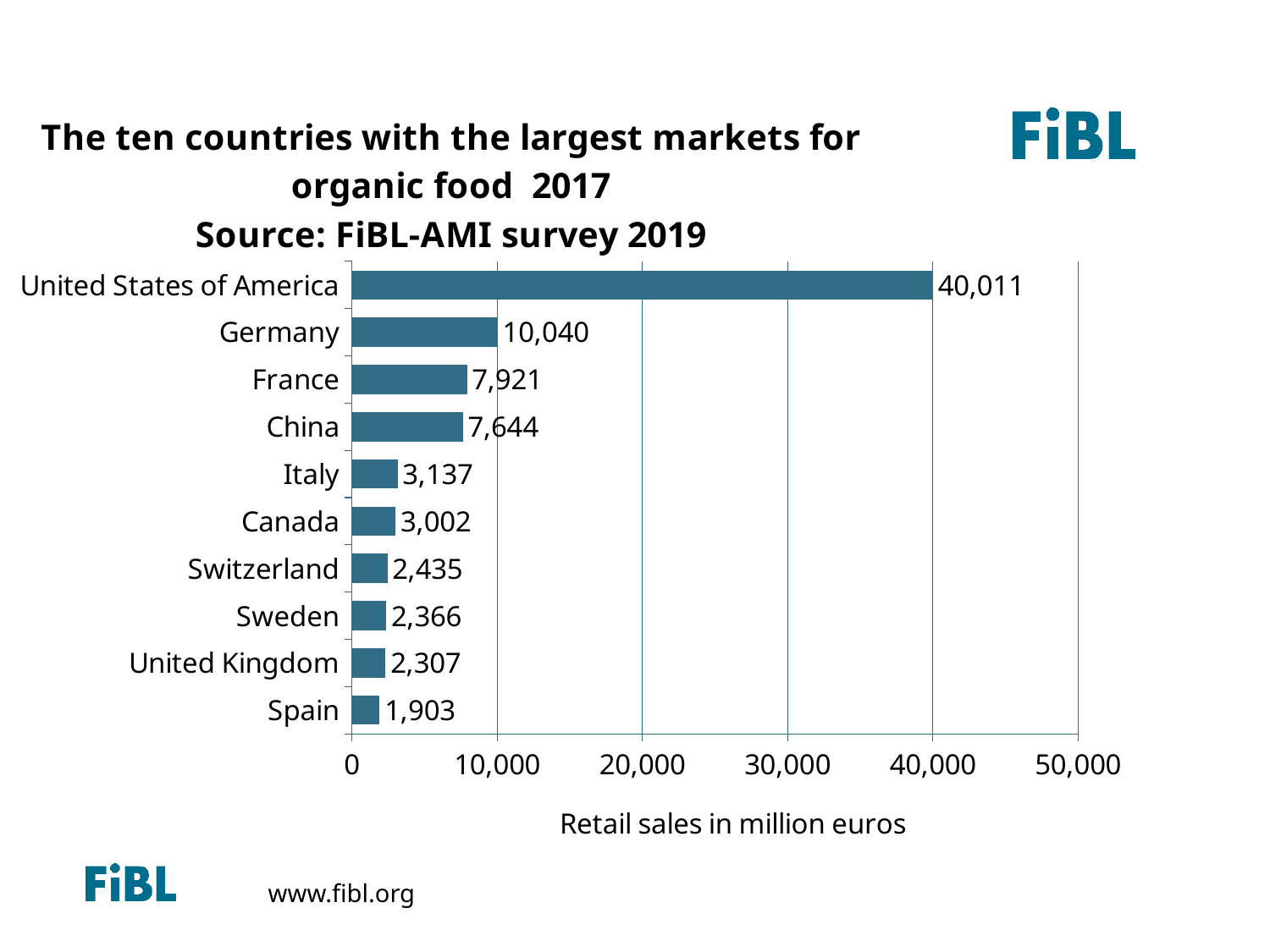
What is the retail sales value for Switzerland? 2,435 Is the value for Germany greater or less than 10,000? greater What is the label of the horizontal axis? Retail sales in million euros What is the retail sales value for Germany? 10,040 Which country has the largest market for organic food? United States of America What kind of chart is shown on the slide? bar chart Which country has the smallest value shown on the chart? Spain What is the retail sales value for China? 7,644 What is the difference between the values for France and China? 277 What is the difference between the values for the United States of America and Germany? 29,971 Which has a higher value, Italy or Canada? Italy How many countries are shown on the chart? 10